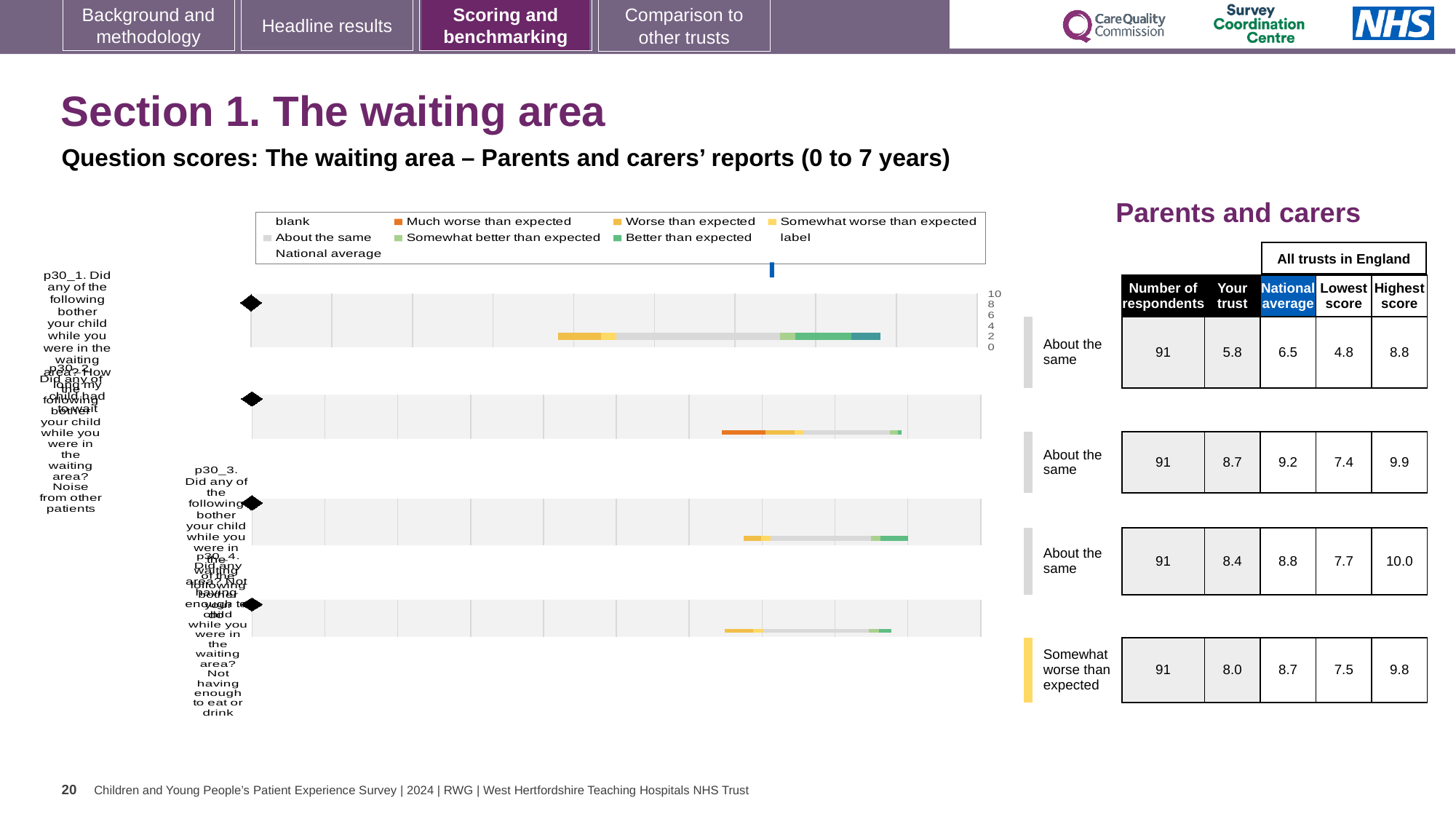
How many entries does the chart legend list? 9 How many question bars are plotted in the chart? 4 In the chart legend, what colour represents 'Much worse than expected'? orange For the row rated 'Somewhat worse than expected', what is the difference between the national average and the 'Your trust' score? 0.7 What is the highest 'Your trust' score among the four rows? 8.7 How many of the four question rows are rated 'About the same'? 3 Which row has the lowest 'Your trust' score, and what is it? The first row, 5.8 What is the national average for the row rated 'Somewhat worse than expected'? 8.7 What is the title of the table to the right of the chart? Parents and carers What kind of chart is shown on the slide? bar chart What is the 'Your trust' score for the row rated 'Somewhat worse than expected'? 8.0 What is the number of respondents shown for the first row? 91